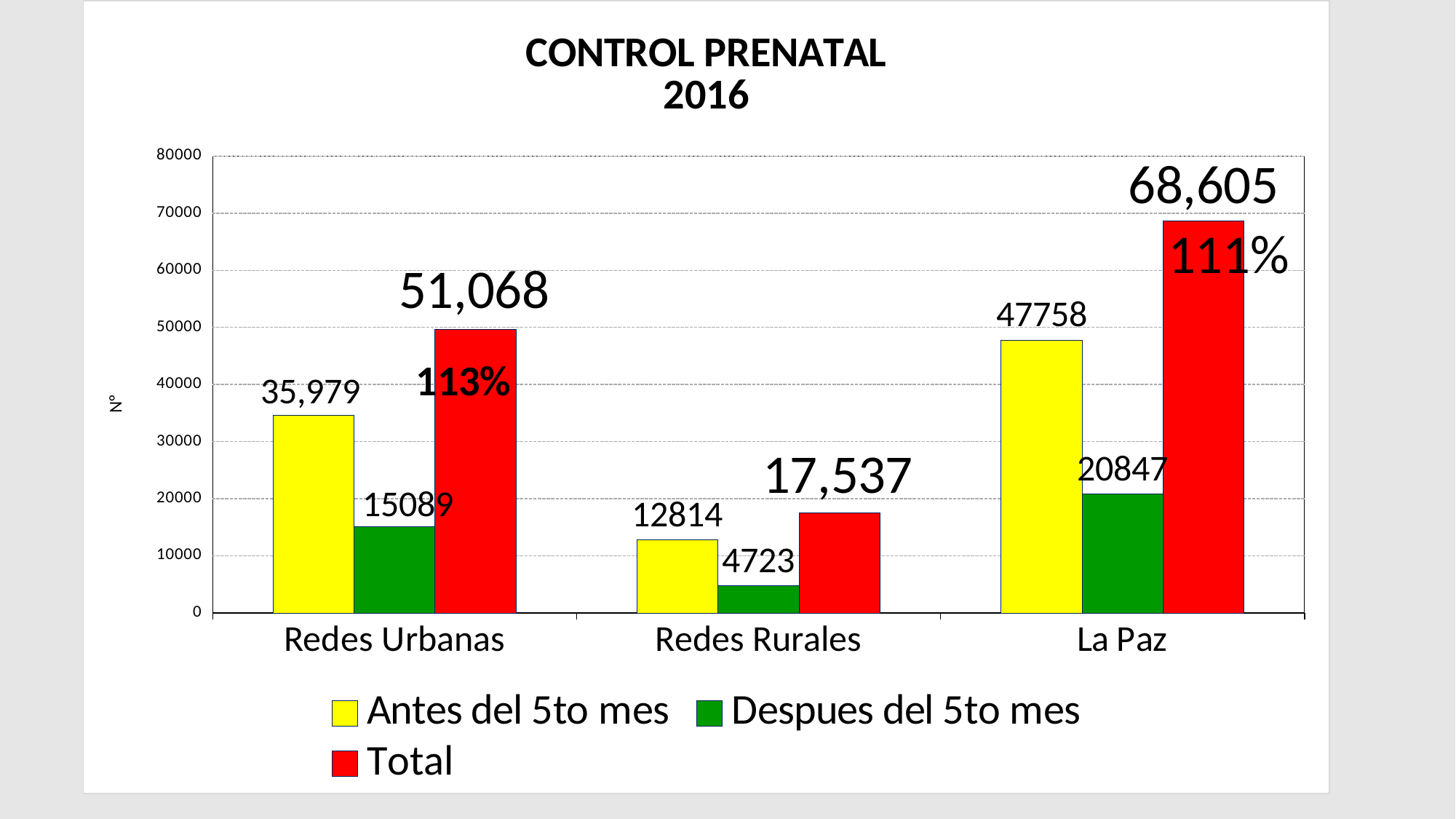
What is the value for Antes del 5to mes in Redes Urbanas? 35,979 How many series does the legend list? 3 How many categories are shown on the x axis? 3 Which category has the lowest value for Antes del 5to mes? Redes Rurales What is the Total value for Redes Rurales? 17,537 Which category has the highest Total value? La Paz Which is larger in La Paz: Antes del 5to mes or Despues del 5to mes? Antes del 5to mes What percentage is shown next to the Total bar for Redes Urbanas? 113% What is the Total value for La Paz? 68,605 What is the value for Despues del 5to mes in Redes Rurales? 4723 What type of chart is shown on the slide? Bar chart What is the difference between the Total values for La Paz and Redes Urbanas? 17,537